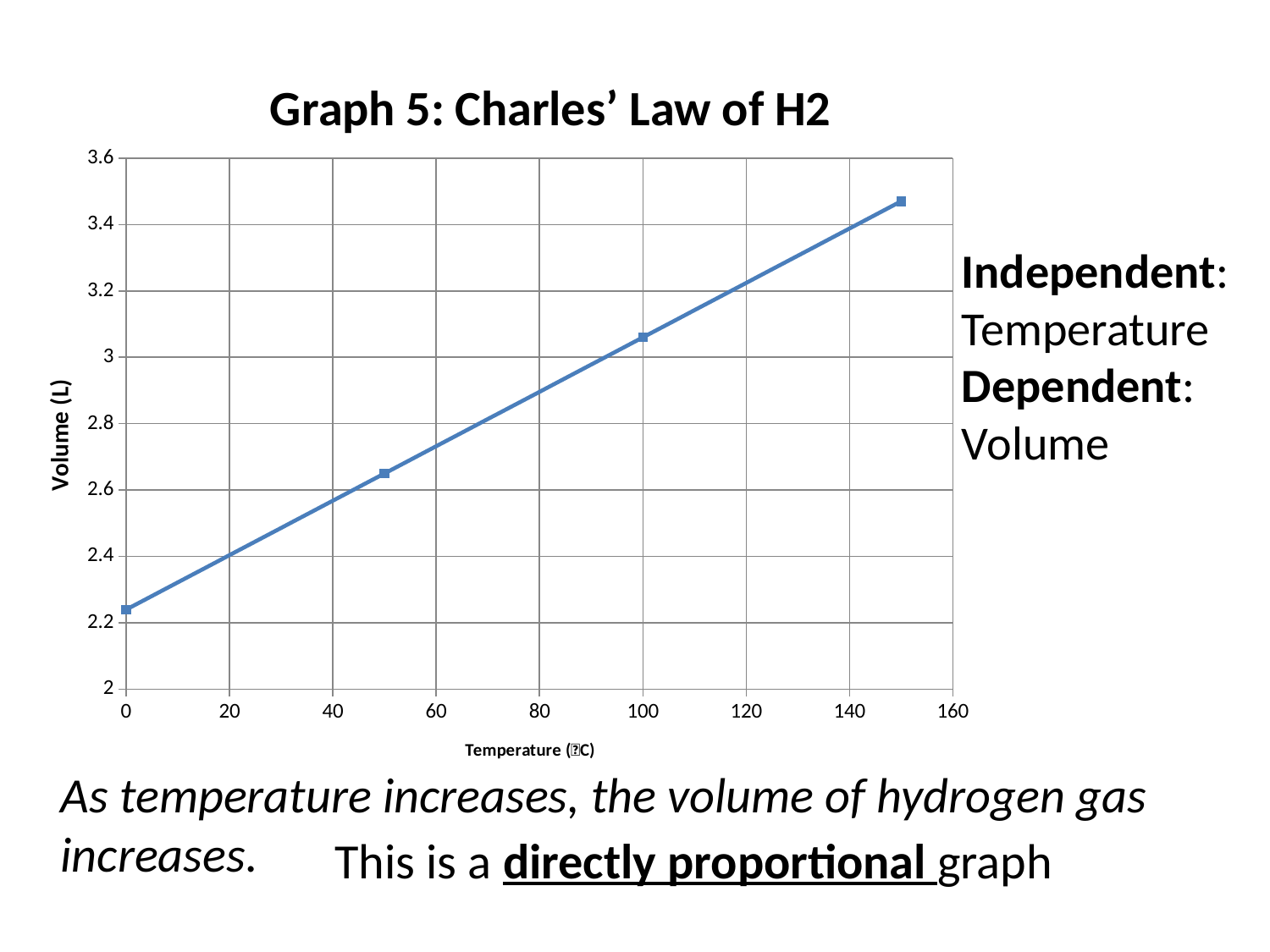
What kind of chart is shown on the slide? line chart Does the volume rise or fall as temperature increases along the x axis? rise What is the label of the y axis? Volume (L) Is the volume at 50 °C greater or less than 2.8 L? less At which temperature is the volume highest? 150 What is the title of the chart? Graph 5: Charles' Law of H2 At which temperature is the volume lowest? 0 Is the volume at 150 °C greater or less than 3.4 L? greater How many data points are plotted on the chart? 4 Which has the larger volume: 100 °C or 50 °C? 100 °C Is the volume at 0 °C greater or less than 2.4 L? less